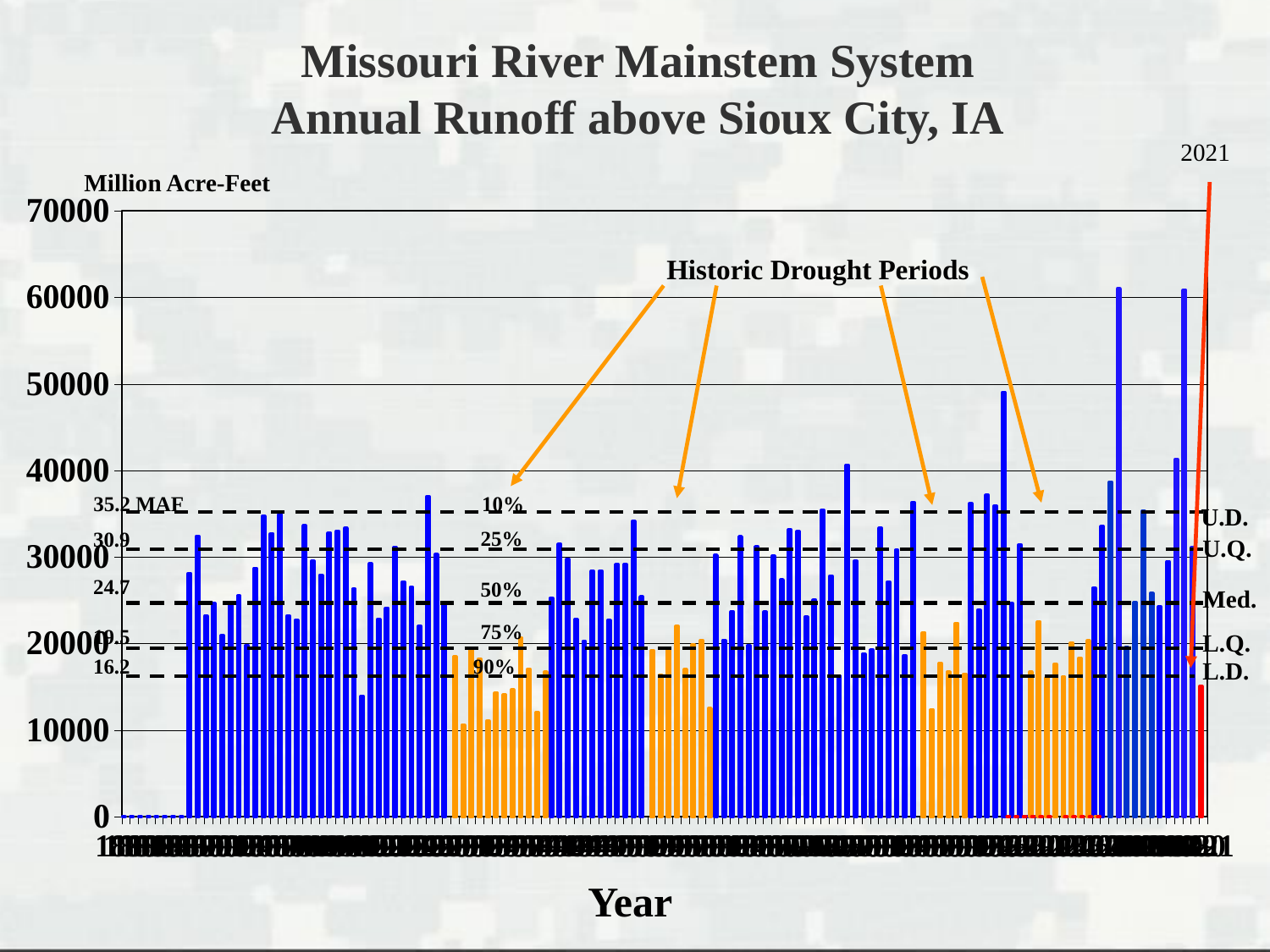
What value is printed on the dashed reference line labelled 90% (L.D.)? 16.2 What is the highest value shown on the vertical axis? 70000 What kind of chart is shown on the slide? bar chart Is the runoff value for 2021 (the red bar) greater or less than 10000? greater What value is printed on the dashed reference line labelled 10%? 35.2 MAF What value is printed on the dashed reference line labelled 50% (Med.)? 24.7 What value is printed on the dashed reference line labelled 75%? 19.5 What value is printed on the dashed reference line labelled 25%? 30.9 What unit is given for the vertical axis of the chart? Million Acre-Feet How many dashed percentile reference lines are drawn across the chart? 5 What is the title of the chart? Missouri River Mainstem System Annual Runoff above Sioux City, IA Is the runoff value for 2021 (the red bar) greater or less than 20000? less